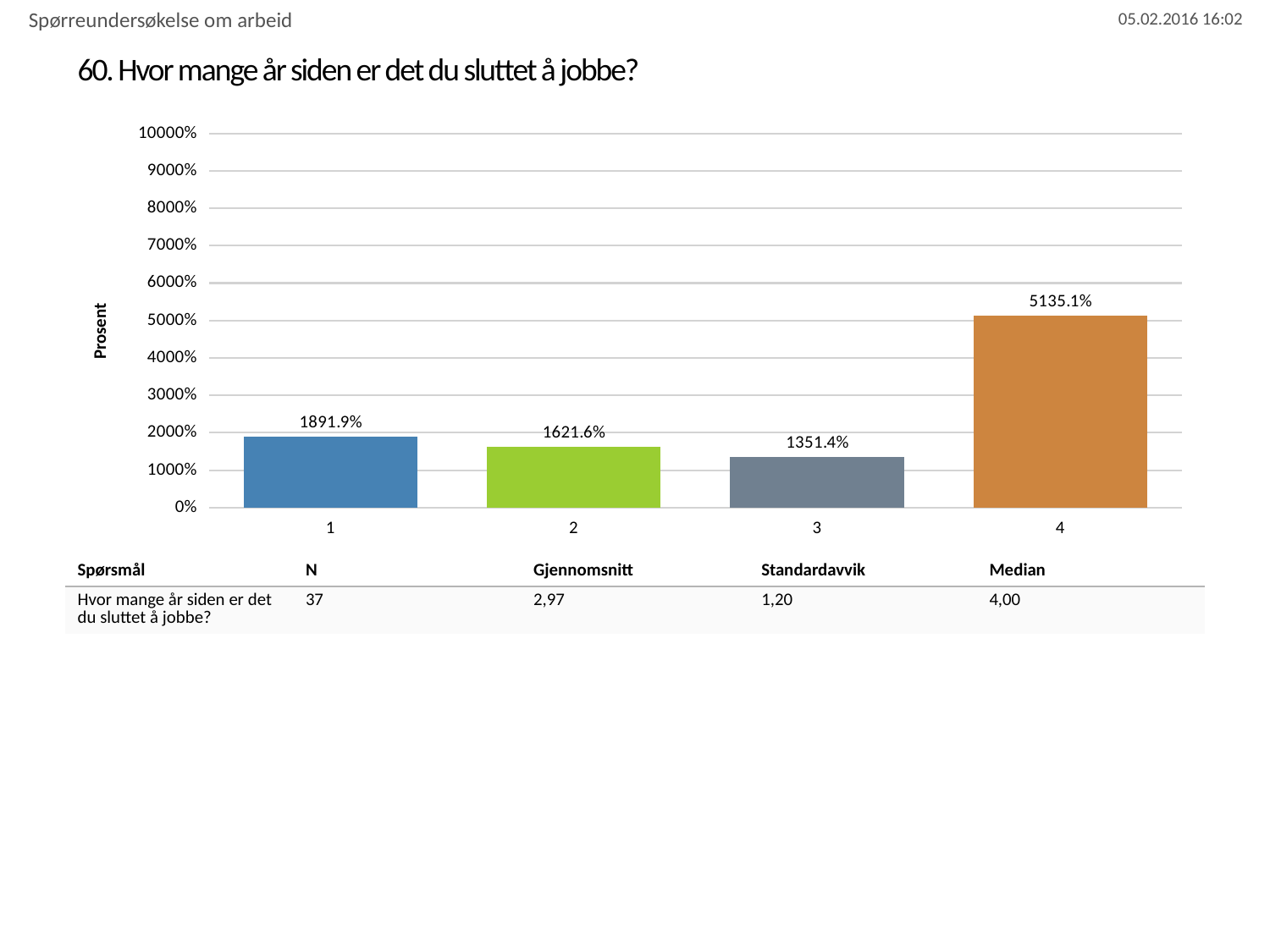
What is the value for category 3? 1351.4% Is the value for category 4 greater or less than 5000%? greater What is the value for category 4? 5135.1% What is the difference between the values for category 4 and category 1? 3243.2% Which category has the highest value? 4 What is the value for category 1? 1891.9% What kind of chart is shown on the slide? bar chart What is the title of the chart? 60. Hvor mange år siden er det du sluttet å jobbe? Which is larger, the value for category 2 or category 3? 2 Which category has the lowest value? 3 How many categories are shown on the x axis? 4 What is the label of the y axis? Prosent